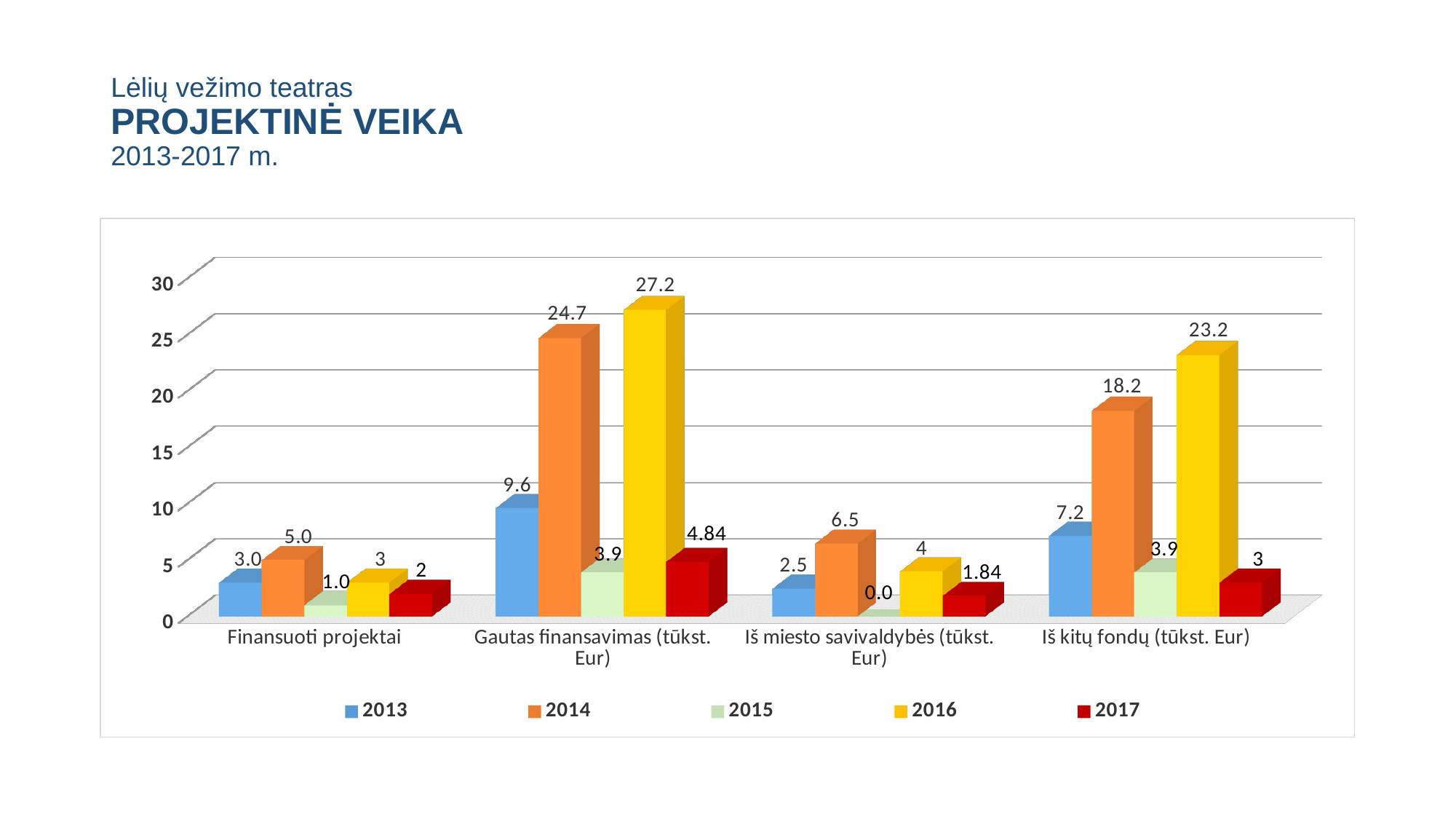
What is the difference between the 2016 and 2014 values in the 'Gautas finansavimas (tūkst. Eur)' category? 2.5 Which year has the lowest value in the 'Finansuoti projektai' category? 2015 How many categories are shown on the x axis? 4 Which year has the highest value in the 'Iš kitų fondų (tūkst. Eur)' category? 2016 Which is larger in the 'Iš miesto savivaldybės (tūkst. Eur)' category: the 2014 value or the 2016 value? 2014 What kind of chart is shown on the slide? Bar chart What is the value for 2015 in the 'Iš miesto savivaldybės (tūkst. Eur)' category? 0.0 What is the value for 2013 in the 'Finansuoti projektai' category? 3.0 What is the value for 2016 in the 'Gautas finansavimas (tūkst. Eur)' category? 27.2 How many series does the legend list? 5 What is the value for 2017 in the 'Iš kitų fondų (tūkst. Eur)' category? 3 Which colour represents the 2016 series in the legend? Yellow